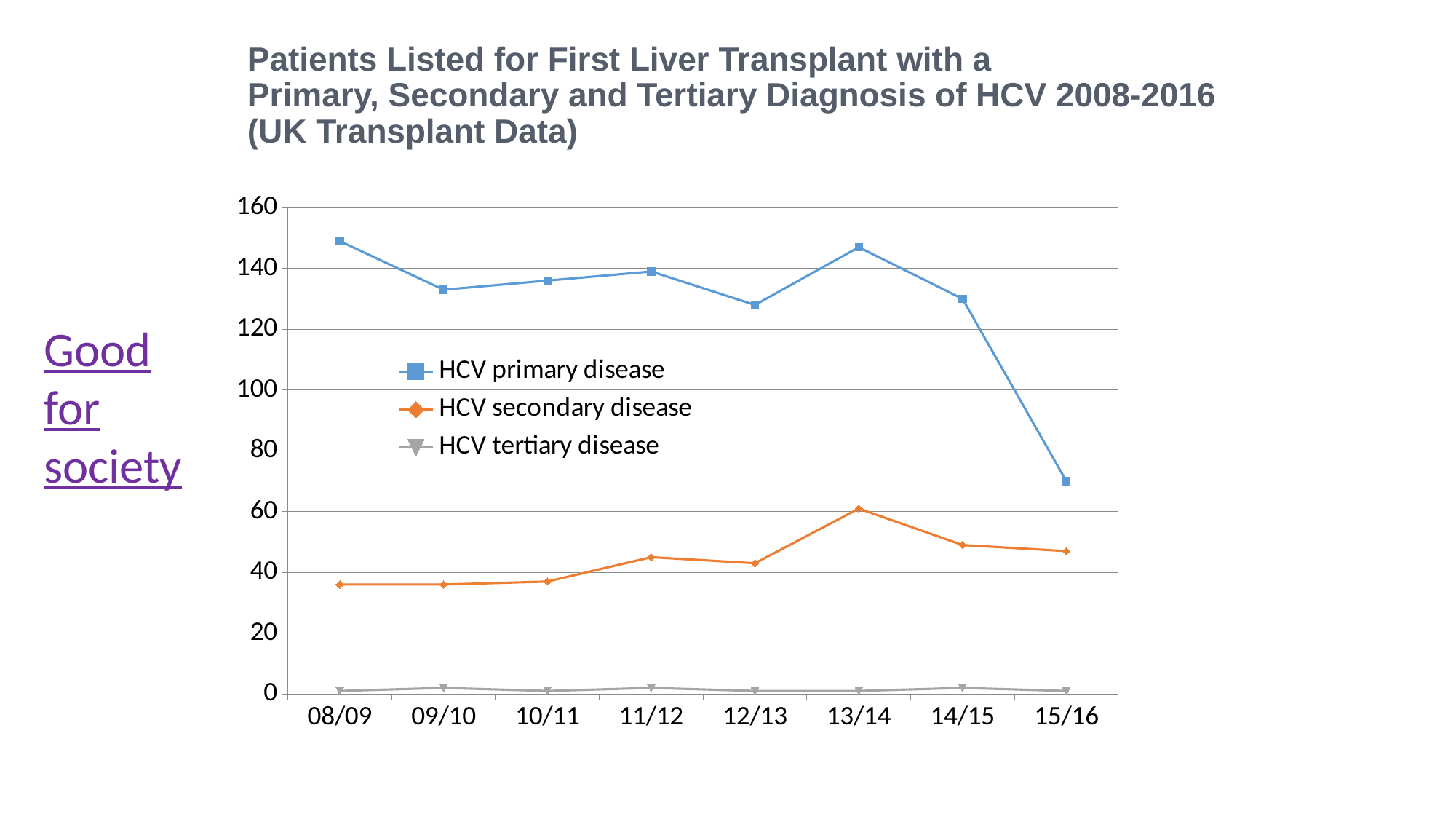
Is the value for HCV primary disease in 08/09 greater or less than 140? greater In which period is the value for HCV primary disease lowest? 15/16 Is the value for HCV secondary disease in 08/09 greater or less than 40? less Is the value for HCV primary disease in 15/16 greater or less than 80? less What kind of chart is shown on the slide? line chart How many series does the legend list? 3 In which period is the value for HCV secondary disease highest? 13/14 How many time periods are shown on the x axis? 8 Does the HCV primary disease line rise or fall from 13/14 to 15/16? fall Which is larger in 15/16: HCV primary disease or HCV secondary disease? HCV primary disease Which series is drawn in orange? HCV secondary disease